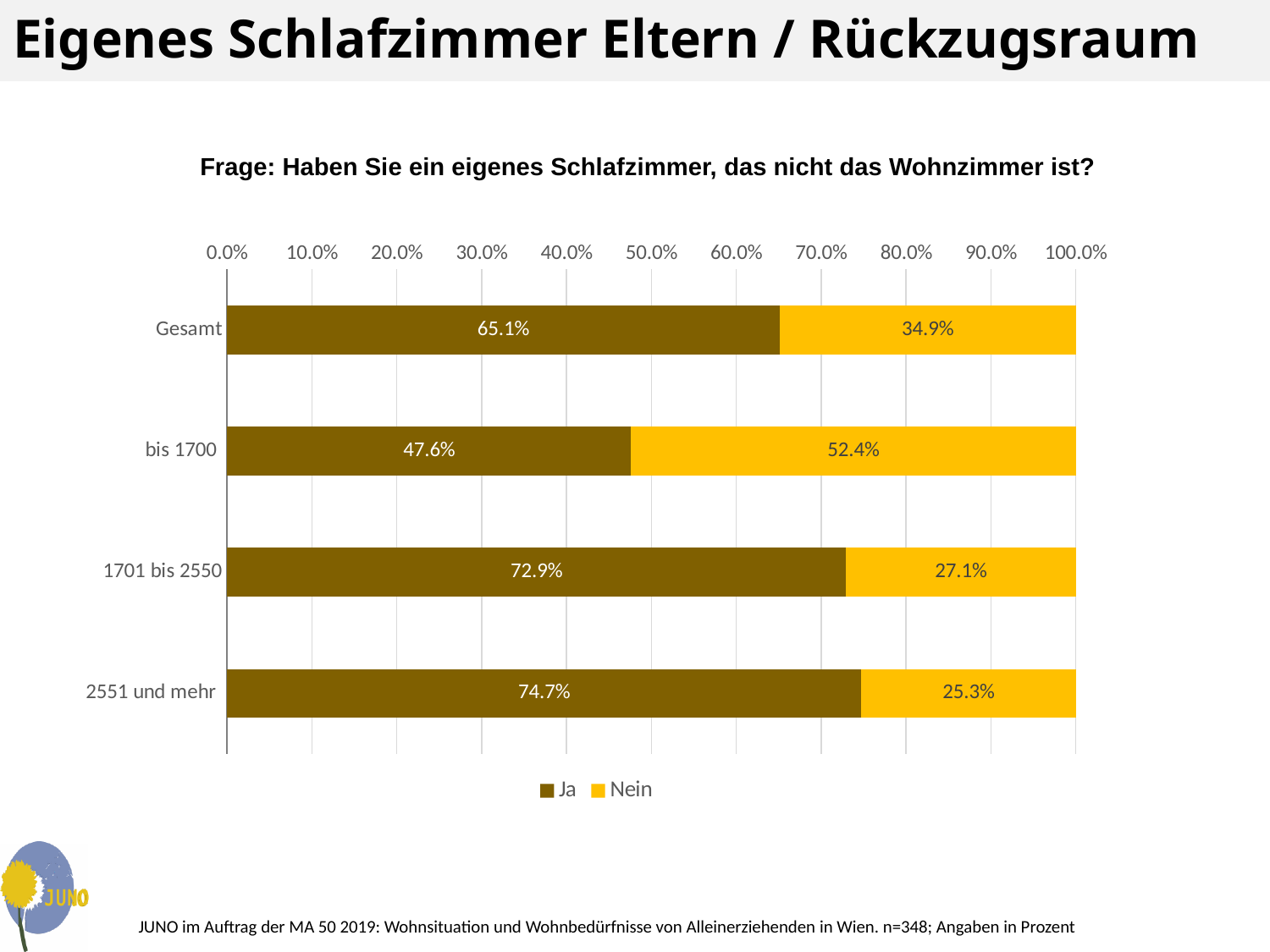
How many series does the legend list? 2 What is the difference between the 'Ja' values for 2551 und mehr and bis 1700? 27.1% How many categories are shown on the y axis? 4 What is the 'Ja' value for Gesamt? 65.1% Which is larger: the 'Nein' value for Gesamt or the 'Nein' value for 1701 bis 2550? Gesamt Which category has the lowest 'Ja' value? bis 1700 What is the 'Nein' value for 2551 und mehr? 25.3% What kind of chart is shown? Stacked bar chart What is the total of the stacked bar for bis 1700? 100.0% What is the 'Ja' value for 1701 bis 2550? 72.9% What is the 'Nein' value for bis 1700? 52.4% Which category has the highest 'Ja' value? 2551 und mehr